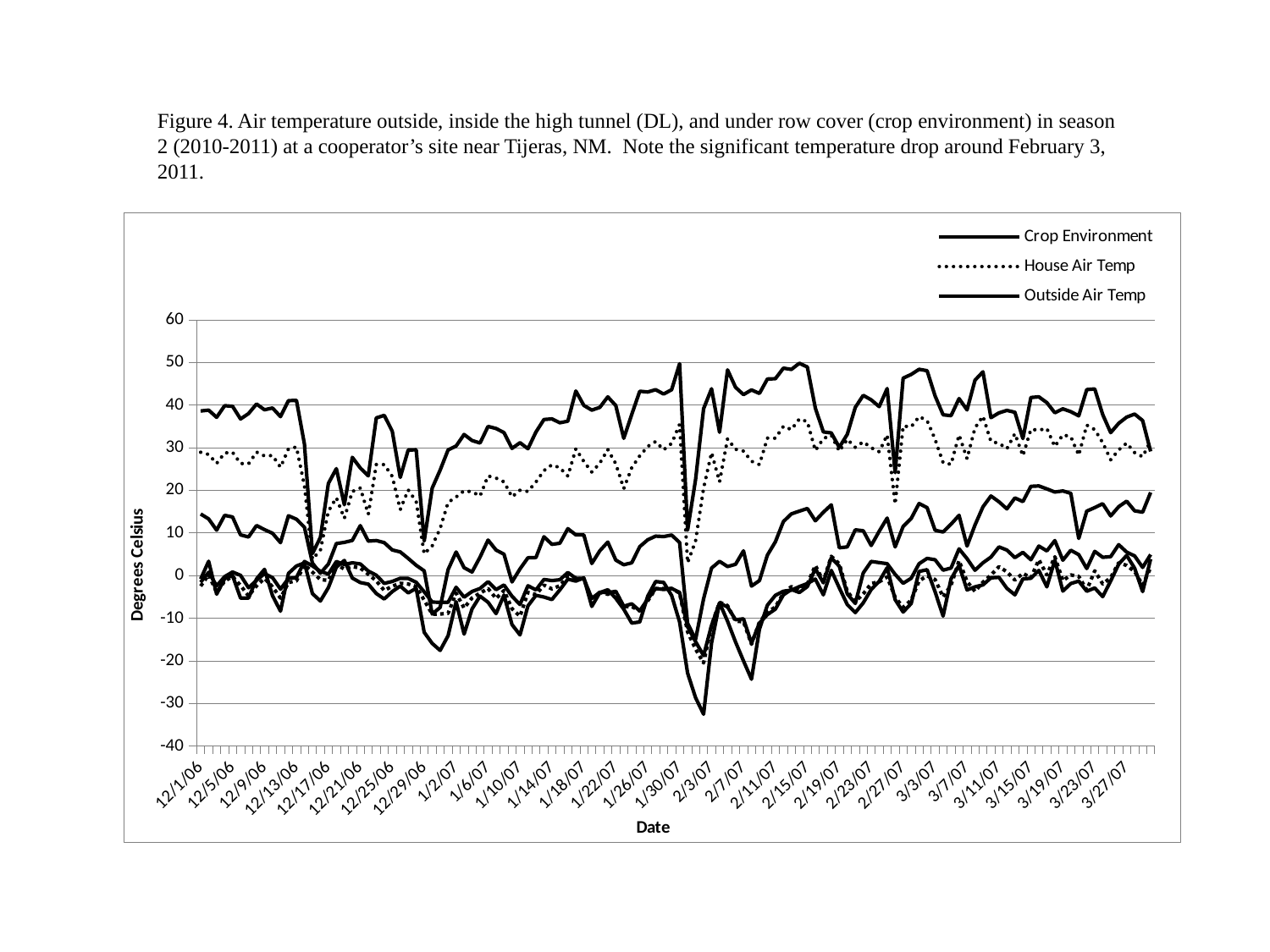
What kind of chart is shown on the slide? line chart How many series does the legend list? 3 What is the label on the vertical axis of the chart? Degrees Celsius What is the maximum value shown on the vertical axis? 60 Which series in the legend is drawn with a dotted line? House Air Temp What is the minimum value shown on the vertical axis? -40 Is the lowest value plotted on the chart, around 2/3/07, greater or less than -30? less